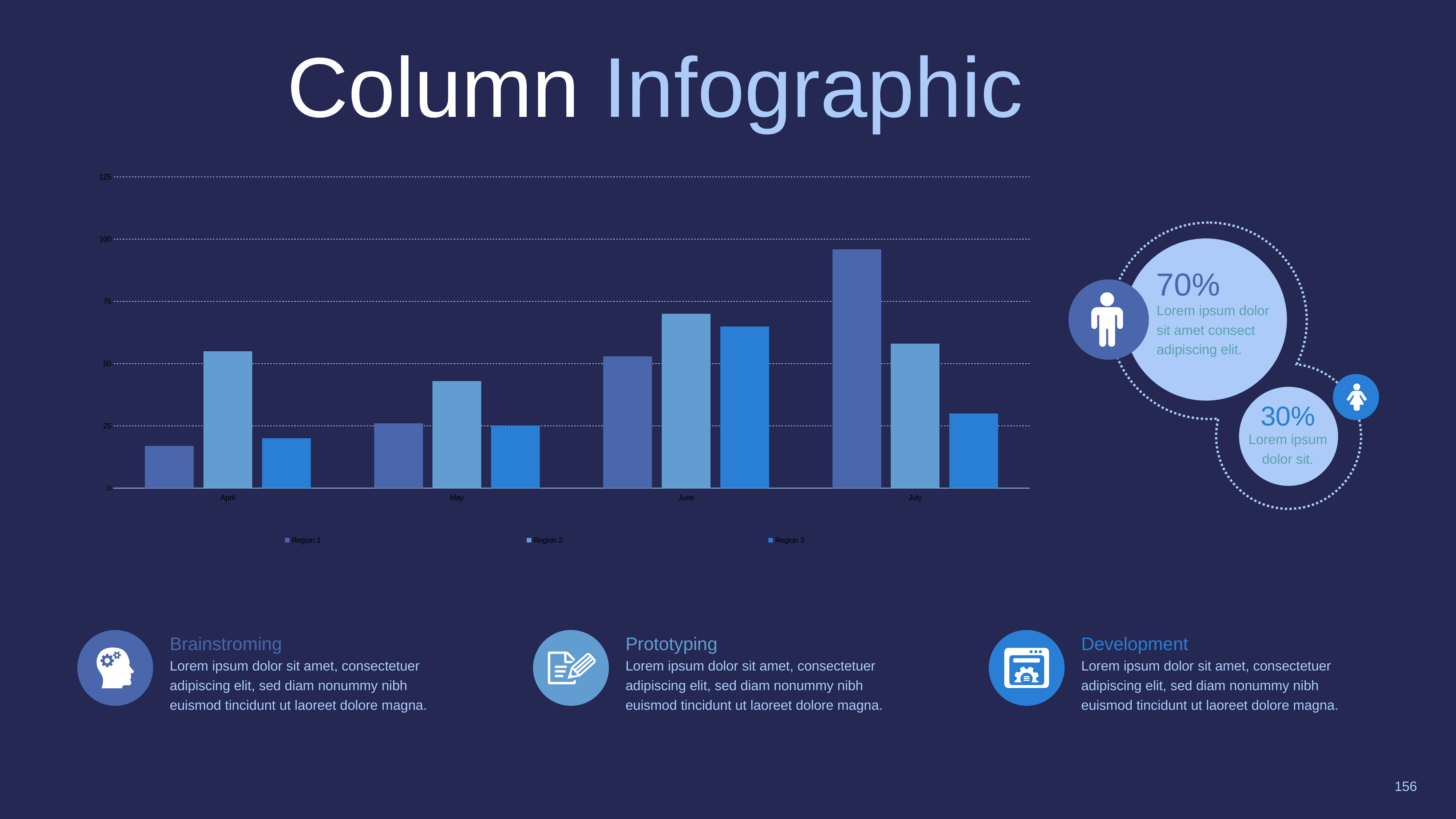
In April, which is larger: Region 2 or Region 3? Region 2 How many series does the chart's legend list? 3 How many categories are shown on the x axis of the chart? 4 In which month is the Region 1 bar lowest? April In which month is the Region 1 bar highest? July Is the value for Region 1 in April greater or less than 25? less In which month is the Region 2 bar highest? June Do the Region 1 values rise or fall from April to July? rise Is the value for Region 3 in June greater or less than 50? greater What kind of chart is shown on the slide? bar chart Is the value for Region 1 in July greater or less than 75? greater Which series are listed in the chart's legend? Region 1, Region 2, Region 3